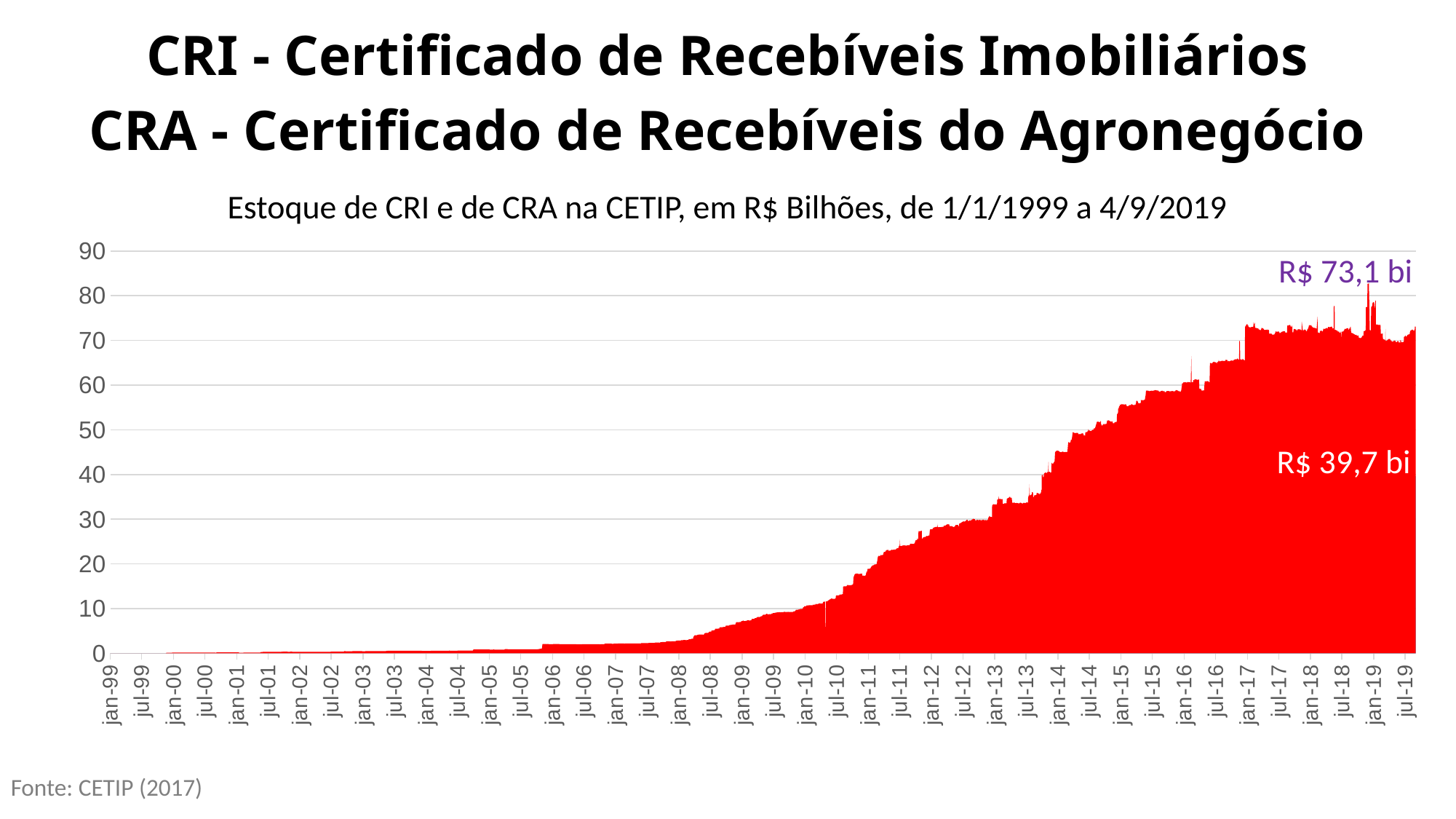
Is the value at jan-08 greater or less than 10? less What value is printed in purple at the top right of the chart? R$ 73,1 bi What value is printed in white inside the red area of the chart? R$ 39,7 bi What is the difference between the two values printed on the chart, R$ 73,1 bi and R$ 39,7 bi? R$ 33,4 bi Do the values in the chart generally rise or fall from jan-99 to jul-19? Rise Is the value at jul-19 greater or less than 60? greater What kind of chart is shown on the slide? Area chart Which of the two values printed on the chart is larger, R$ 73,1 bi or R$ 39,7 bi? R$ 73,1 bi What is the subtitle printed above the chart? Estoque de CRI e de CRA na CETIP, em R$ Bilhões, de 1/1/1999 a 4/9/2019 Is the value at jan-12 greater or less than 20? greater What source is cited at the bottom of the slide? Fonte: CETIP (2017)